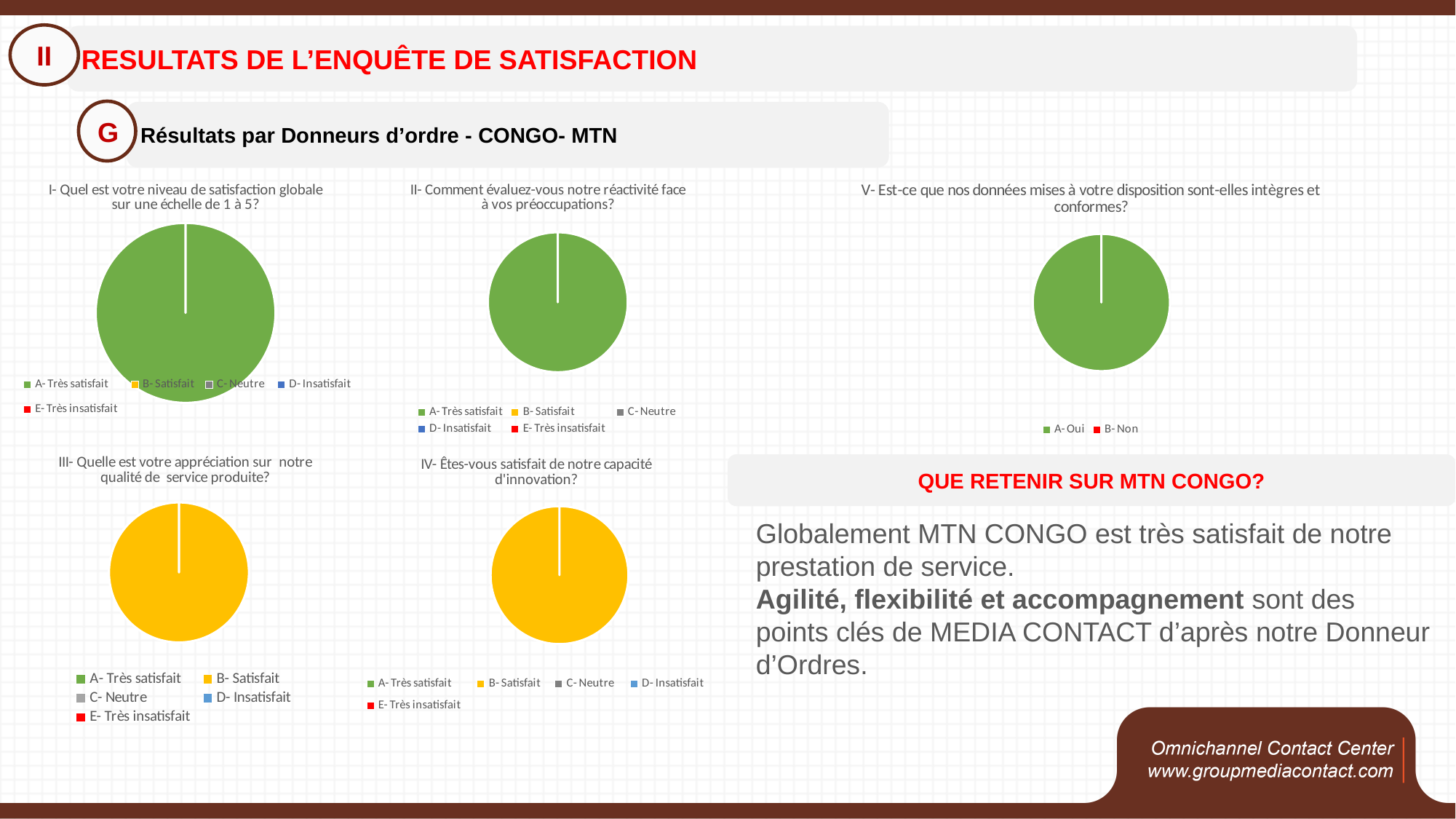
How many entries does the legend list for the chart "II- Comment évaluez-vous notre réactivité face à vos préoccupations?"? 5 In the chart "IV- Êtes-vous satisfait de notre capacité d'innovation?", which category fills the entire pie? B- Satisfait In the chart "III- Quelle est votre appréciation sur notre qualité de service produite?", what colour represents "E- Très insatisfait" in the legend? Red In the chart "V- Est-ce que nos données mises à votre disposition sont-elles intègres et conformes?", what colour represents "B- Non" in the legend? Red In the chart "II- Comment évaluez-vous notre réactivité face à vos préoccupations?", which category has the largest slice? A- Très satisfait In the chart "I- Quel est votre niveau de satisfaction globale sur une échelle de 1 à 5?", which category fills the entire pie? A- Très satisfait How many pie charts are shown on the slide? 5 How many entries does the legend list for the chart "I- Quel est votre niveau de satisfaction globale sur une échelle de 1 à 5?"? 5 What kind of chart is used for "I- Quel est votre niveau de satisfaction globale sur une échelle de 1 à 5?"? Pie chart How many entries does the legend list for the chart "V- Est-ce que nos données mises à votre disposition sont-elles intègres et conformes?"? 2